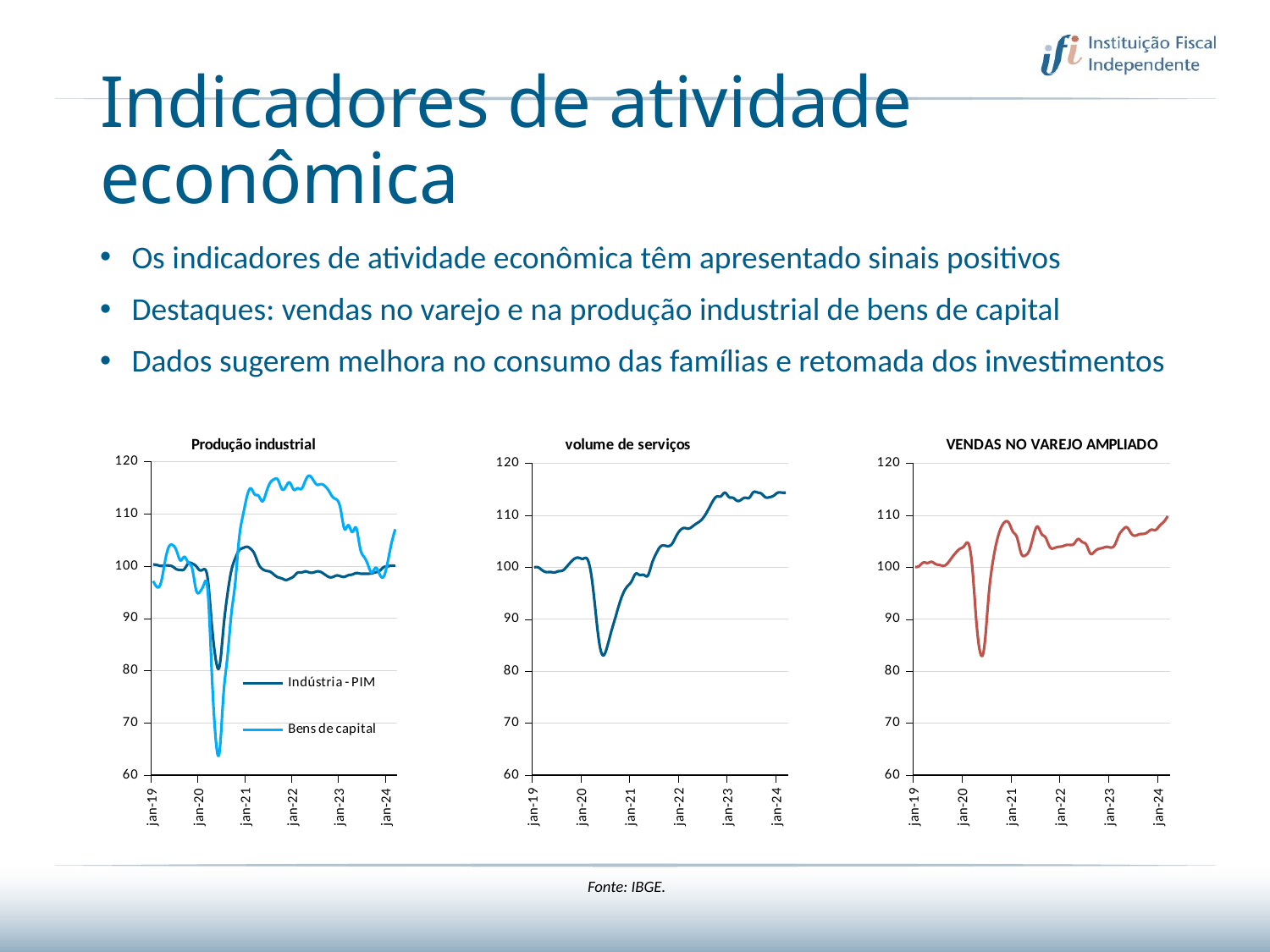
In the "volume de serviços" chart, is the value at jan-19 greater or less than 110? less What are the two legend entries in the "Produção industrial" chart? Indústria - PIM and Bens de capital In the "Produção industrial" chart, is the Bens de capital value at jan-22 greater or less than 110? greater In the "volume de serviços" chart, is the value at jan-24 greater or less than 110? greater How many series does the legend of the "Produção industrial" chart list? 2 What kind of chart is the "Produção industrial" chart? line chart In the "Produção industrial" chart, which series is higher at jan-22, Bens de capital or Indústria - PIM? Bens de capital What is the title of the rightmost chart on the slide? VENDAS NO VAREJO AMPLIADO In the "volume de serviços" chart, does the line generally rise or fall from jan-21 to jan-24? rise